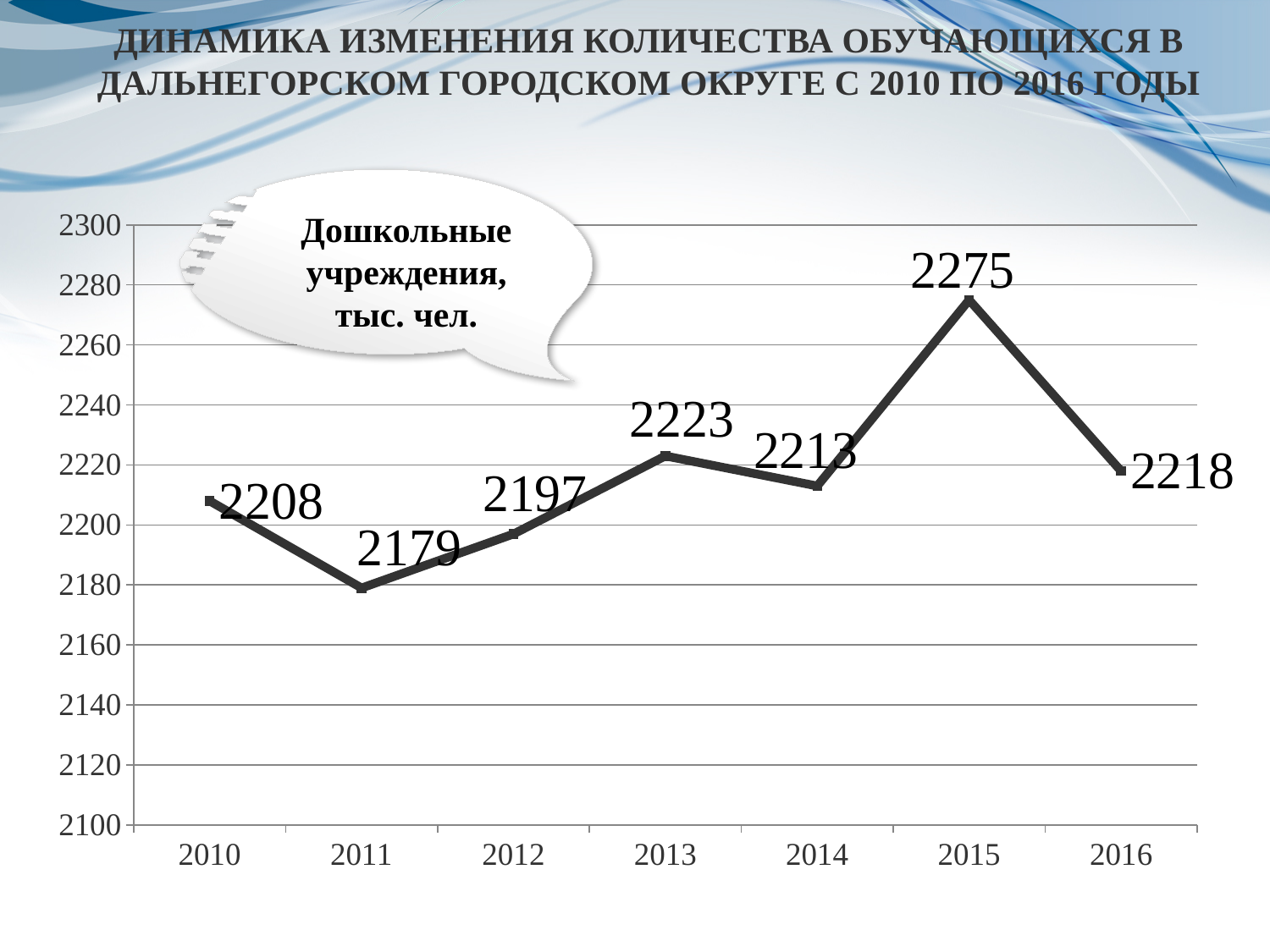
Is the value for 2011 greater or less than 2200? less How many years are plotted on the chart? 7 What is the value for 2015? 2275 Does the value rise or fall from 2015 to 2016? fall What kind of chart is shown on the slide? line chart Which is larger, the value for 2016 or the value for 2014? 2016 What is the difference between the values for 2015 and 2011? 96 What is the value for 2012? 2197 Which year has the highest value? 2015 What is the difference between the values for 2013 and 2014? 10 Which year has the lowest value? 2011 What is the value for 2010? 2208